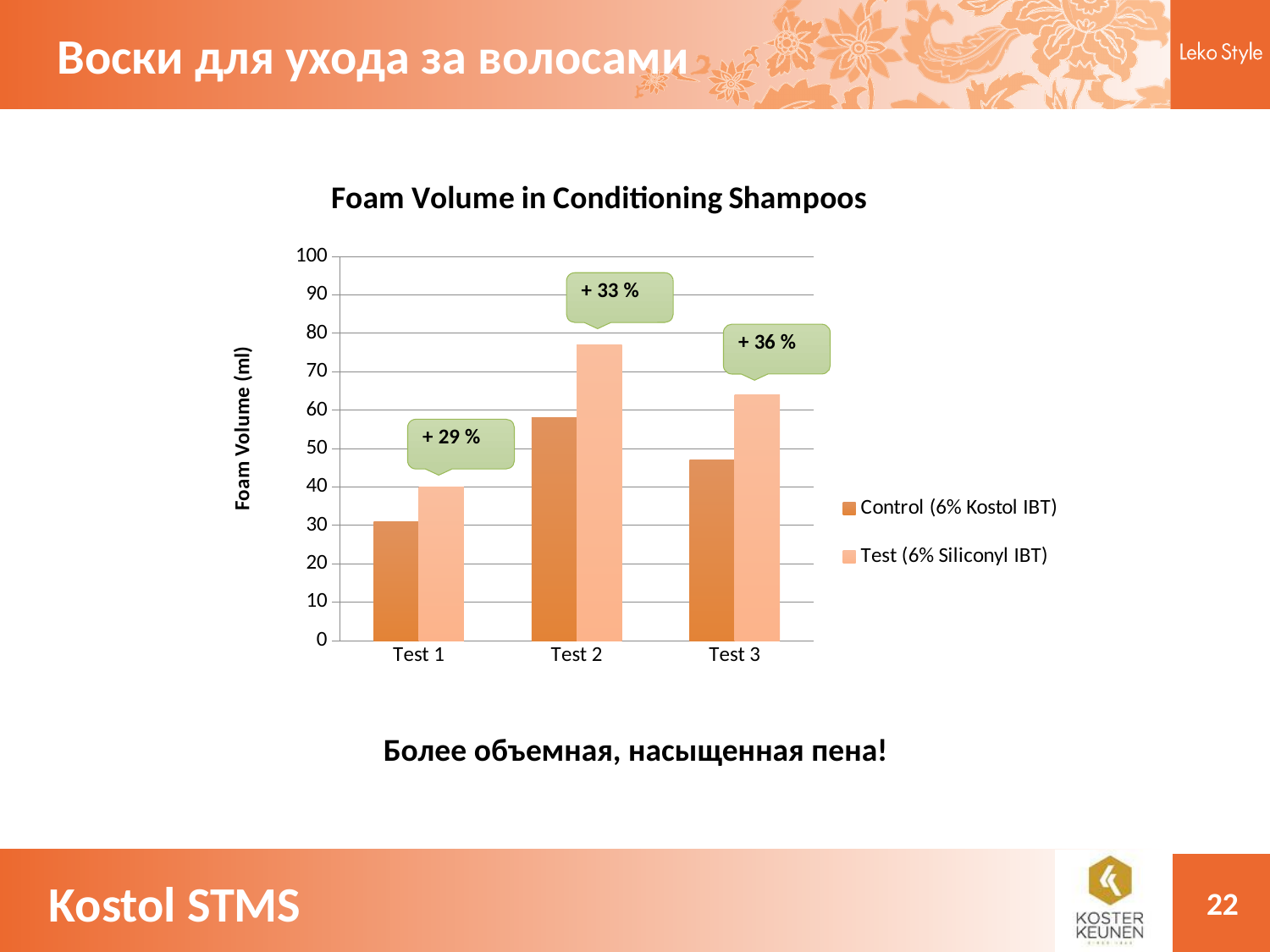
Is the Control (6% Kostol IBT) value for Test 3 greater or less than 50? less What is the title of the chart? Foam Volume in Conditioning Shampoos How many categories are shown on the x axis? 3 In Test 1, which series has the larger value, Control (6% Kostol IBT) or Test (6% Siliconyl IBT)? Test (6% Siliconyl IBT) Which category has the highest value for Test (6% Siliconyl IBT)? Test 2 Is the Control (6% Kostol IBT) value for Test 1 greater or less than 40? less Which is larger: the Control (6% Kostol IBT) value for Test 2 or for Test 3? Test 2 Is the Test (6% Siliconyl IBT) value for Test 2 greater or less than 70? greater What percentage increase is shown in the callout above Test 3? + 36 % Which category has the lowest value for Control (6% Kostol IBT)? Test 1 How many series does the legend list? 2 What kind of chart is shown on the slide? bar chart